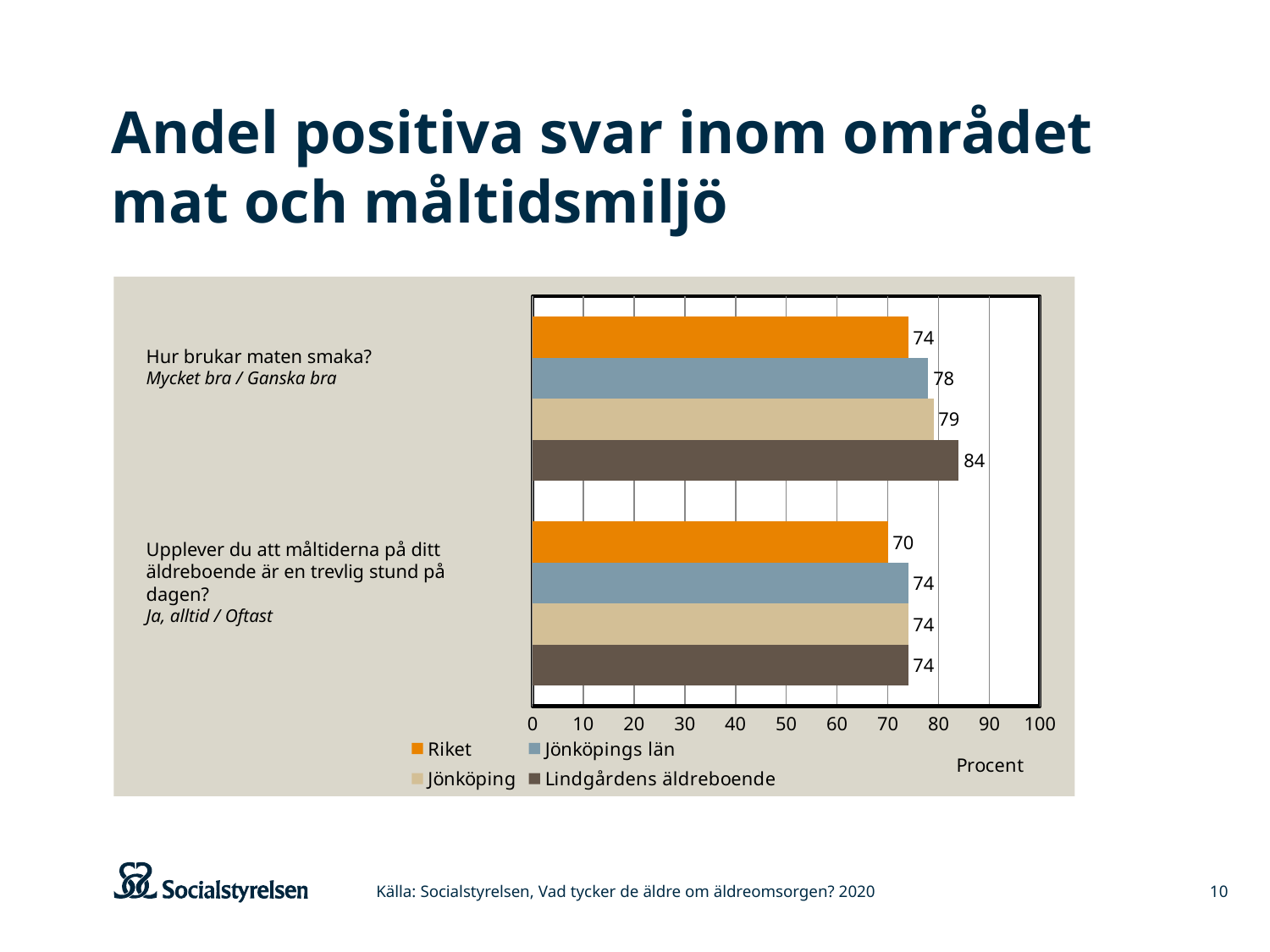
Which is larger for "Hur brukar maten smaka?": Jönköping or Riket? Jönköping What kind of chart is shown on the slide? Bar chart What is the difference between Lindgårdens äldreboende and Riket on "Hur brukar maten smaka?"? 10 How many series does the legend list? 4 Which series has the highest value for "Hur brukar maten smaka?"? Lindgårdens äldreboende How many questions (categories) are shown in the chart? 2 What is the value for Jönköpings län on the question "Hur brukar maten smaka?"? 78 What is the value for Jönköping on the question "Upplever du att måltiderna på ditt äldreboende är en trevlig stund på dagen?"? 74 Which series has the lowest value for "Upplever du att måltiderna på ditt äldreboende är en trevlig stund på dagen?"? Riket What is the value for Lindgårdens äldreboende on the question "Hur brukar maten smaka?"? 84 What is the label on the horizontal axis of the chart? Procent What is the value for Riket on the question "Upplever du att måltiderna på ditt äldreboende är en trevlig stund på dagen?"? 70